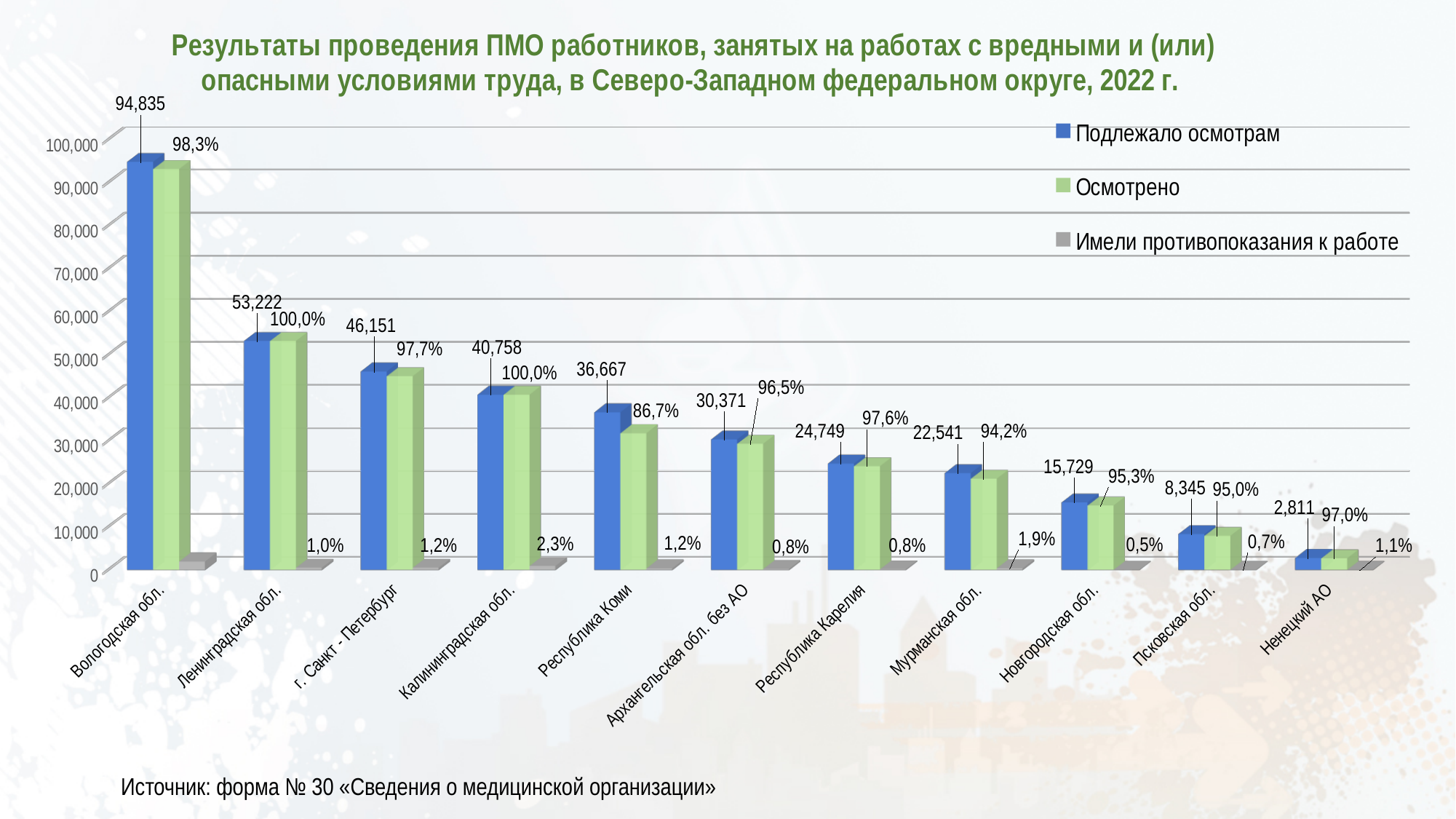
Which is larger, the "Подлежало осмотрам" value for Мурманская обл. or for Новгородская обл.? Мурманская обл. How many series does the legend list? 3 What is the value of "Подлежало осмотрам" for Вологодская обл.? 94,835 Which region has the lowest value of "Подлежало осмотрам"? Ненецкий АО Which region has the highest value of "Подлежало осмотрам"? Вологодская обл. What is the value of "Подлежало осмотрам" for Ненецкий АО? 2,811 What kind of chart is shown on the slide? Bar chart What is the "Имели противопоказания к работе" label shown for Калининградская обл.? 2,3% Do the "Подлежало осмотрам" values rise or fall from left to right along the x axis? Fall What is the "Осмотрено" label shown for Республика Коми? 86,7% What is the difference between the "Подлежало осмотрам" values for Ленинградская обл. and г. Санкт - Петербург? 7,071 How many regions are shown on the x axis? 11